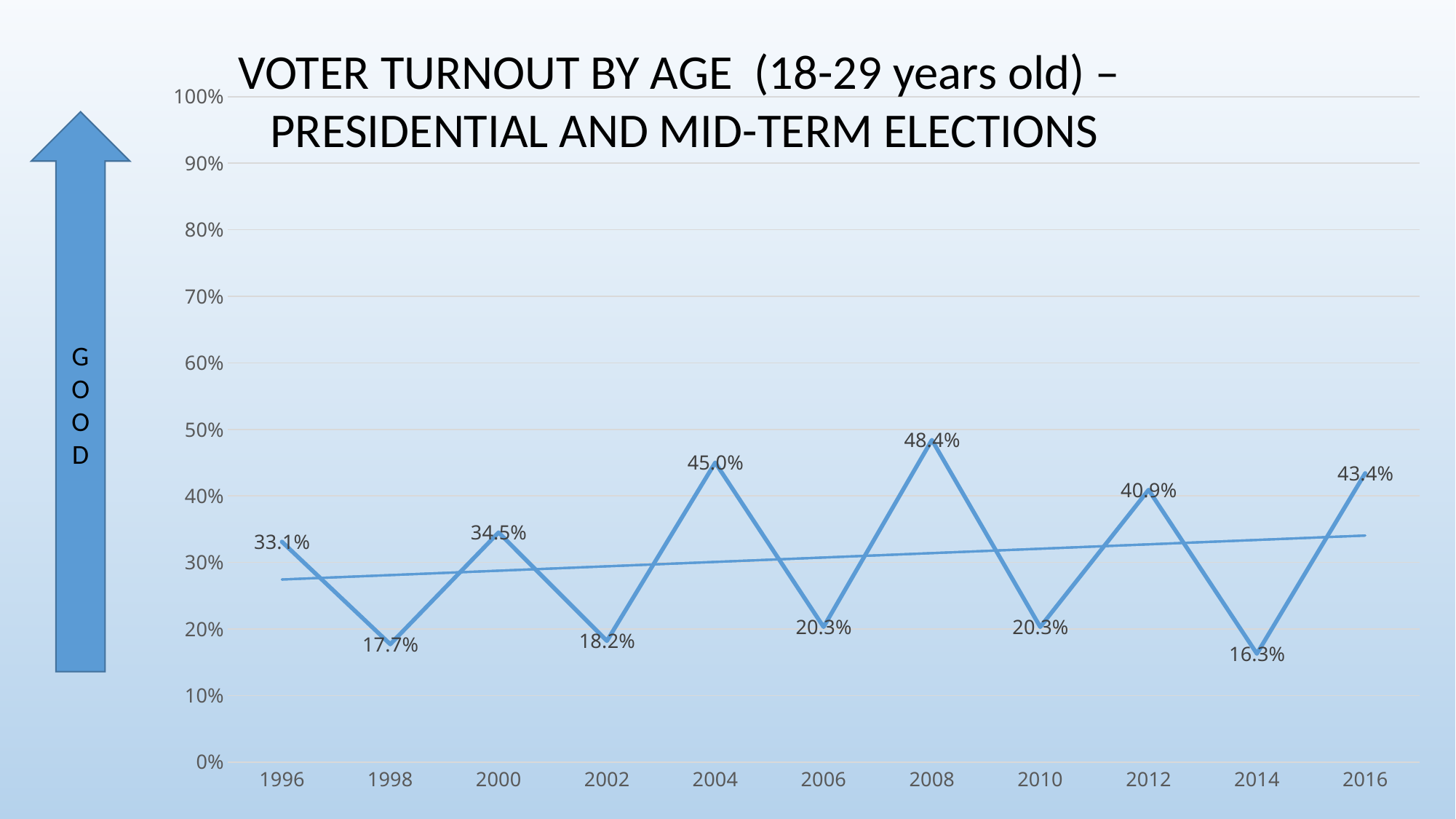
Which year had the highest voter turnout for 18-29 year olds? 2008 What is the title of the chart? VOTER TURNOUT BY AGE (18-29 years old) – PRESIDENTIAL AND MID-TERM ELECTIONS How many election years are plotted on the chart? 11 What kind of chart is shown on the slide? Line chart Which year had the lowest voter turnout for 18-29 year olds? 2014 What is the difference in voter turnout between 2008 and 2014? 32.1% What is the difference in voter turnout between 2016 and 2012? 2.5% What was the voter turnout for 18-29 year olds in 1996? 33.1% What was the voter turnout for 18-29 year olds in 2014? 16.3% What was the voter turnout for 18-29 year olds in 2008? 48.4% Which year had a higher voter turnout, 2004 or 2016? 2004 Is the voter turnout for 2012 greater or less than 40%? greater